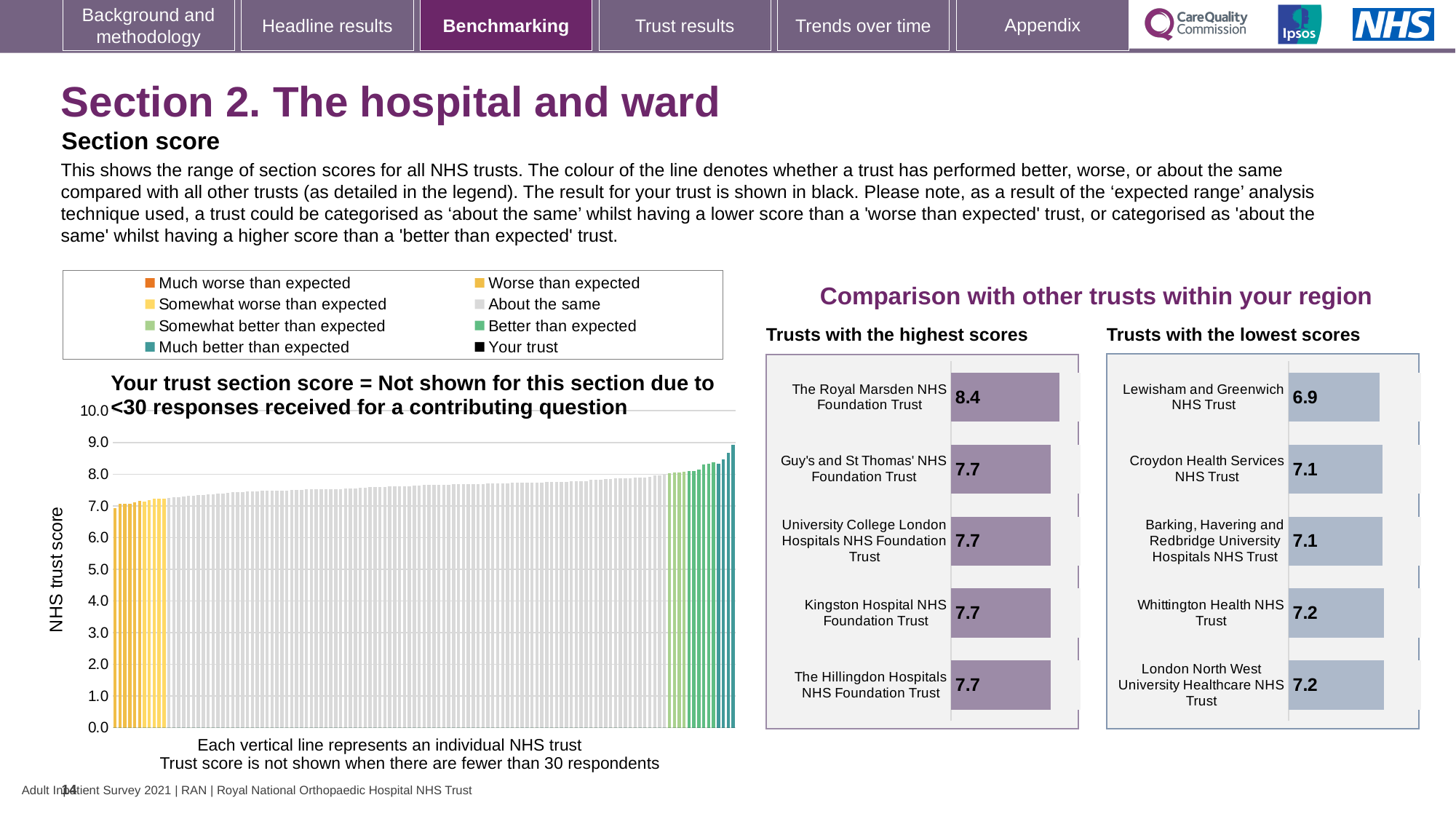
How many trusts are listed in the 'Trusts with the highest scores' chart? 5 In the large chart on the left showing all NHS trusts, is the value of the tallest bar greater or less than 8.0? greater In the 'Trusts with the lowest scores' chart, what is the score for Whittington Health NHS Trust? 7.2 In the 'Trusts with the highest scores' chart, what is the score for The Royal Marsden NHS Foundation Trust? 8.4 In the 'Trusts with the lowest scores' chart, which trust has the lowest score? Lewisham and Greenwich NHS Trust In the 'Trusts with the lowest scores' chart, what is the score for Lewisham and Greenwich NHS Trust? 6.9 How many entries does the legend above the large chart on the left list? 8 Which is larger: Croydon Health Services NHS Trust's score in the 'Trusts with the lowest scores' chart or Guy's and St Thomas' NHS Foundation Trust's score in the 'Trusts with the highest scores' chart? Guy's and St Thomas' NHS Foundation Trust In the 'Trusts with the highest scores' chart, which trust has the highest score? The Royal Marsden NHS Foundation Trust In the 'Trusts with the highest scores' chart, what is the difference between the scores of The Royal Marsden NHS Foundation Trust and Kingston Hospital NHS Foundation Trust? 0.7 What kind of chart is the 'Trusts with the lowest scores' chart? Bar chart What is the difference between The Royal Marsden NHS Foundation Trust's score in the 'Trusts with the highest scores' chart and Lewisham and Greenwich NHS Trust's score in the 'Trusts with the lowest scores' chart? 1.5